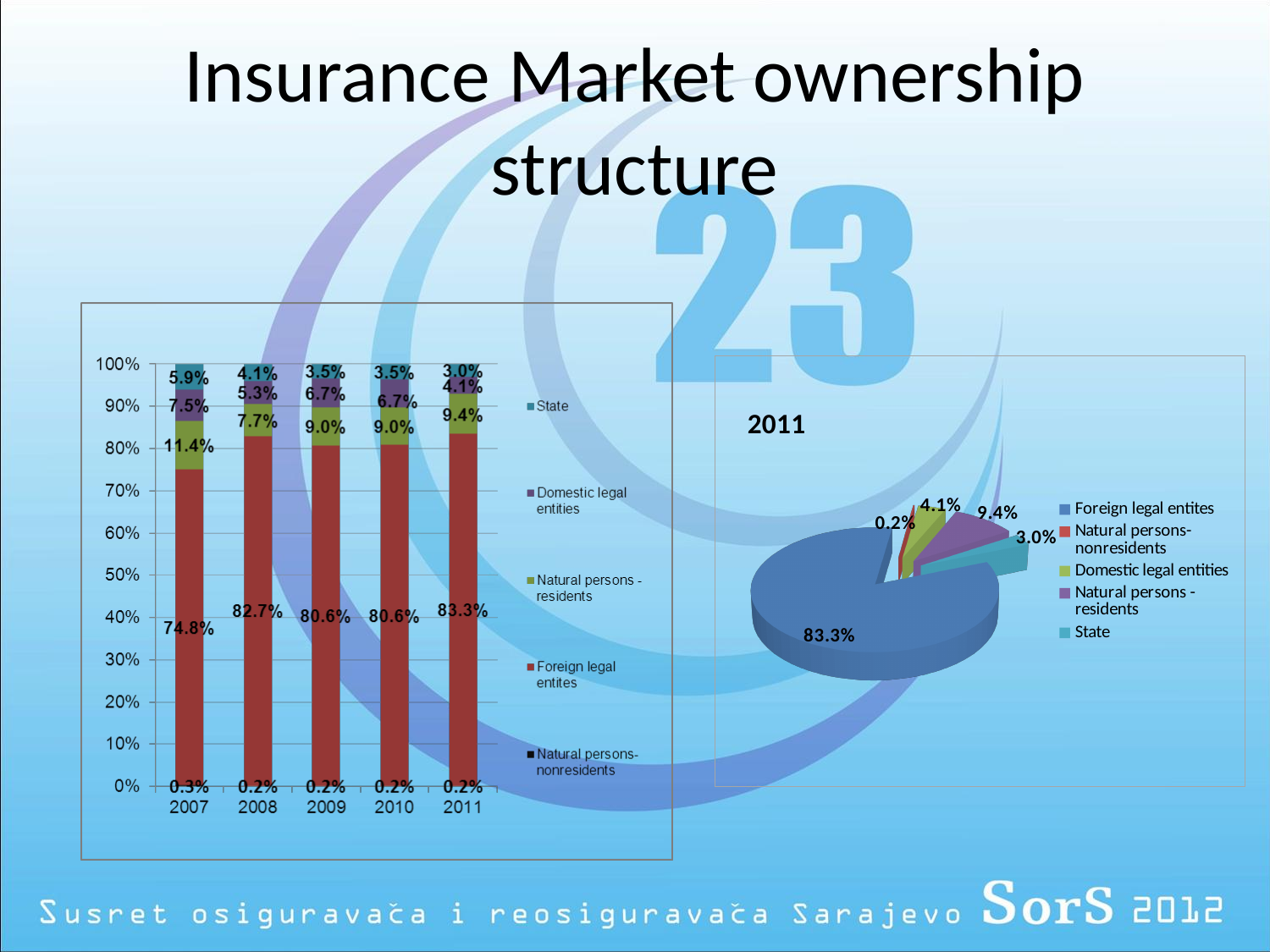
In the stacked bar chart on the left, how many years are shown on the x axis? 5 In the stacked bar chart on the left, which year has the lowest value for State? 2011 In the stacked bar chart on the left, what is the value for Natural persons - residents in 2010? 9.0% In the stacked bar chart on the left, what is the value for State in 2008? 4.1% In the pie chart titled 2011, what share does Natural persons - residents have? 9.4% In the stacked bar chart on the left, how many series does the legend list? 5 In the stacked bar chart on the left, what is the difference between the Foreign legal entities value in 2011 and in 2007? 8.5% What kind of chart is the chart on the right titled 2011? Pie chart In the pie chart titled 2011, which category has the smallest slice? Natural persons-nonresidents In the stacked bar chart on the left, what is the value for Foreign legal entities in 2007? 74.8% In the stacked bar chart on the left, is the Domestic legal entities value larger in 2007 or in 2011? 2007 In the stacked bar chart on the left, which year has the highest value for Foreign legal entities? 2011